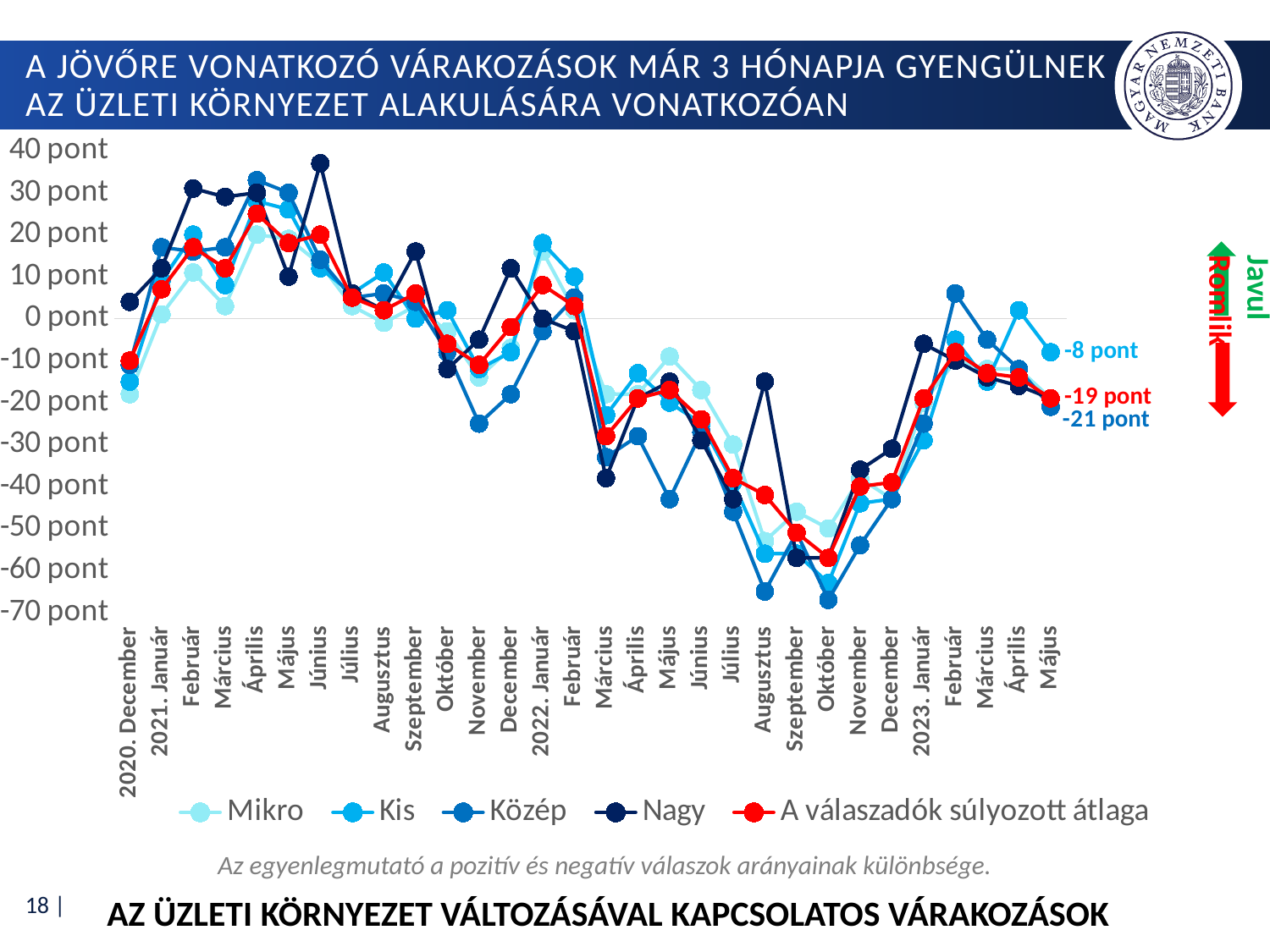
In which month does 'A válaszadók súlyozott átlaga' reach its lowest value? 2022. Október What is the value of the 'Közép' series in 2023. Május? -21 pont What is the value of the 'Kis' series in 2023. Május? -8 pont How many series does the legend list? 5 In 2023. Május, what is the difference between the 'Kis' value and the 'Közép' value? 13 pont Is the value for 'Nagy' in 2021. Június greater or less than 30 pont? greater Does 'A válaszadók súlyozott átlaga' rise or fall from 2022. Október to 2023. Február? rise What kind of chart is shown on the slide? line chart In 2023. Május, which is larger: the 'Kis' value or the 'Közép' value? Kis How many months (categories) are shown on the x axis? 30 What is the value of 'A válaszadók súlyozott átlaga' in 2023. Május? -19 pont Is the value for 'Közép' in 2022. Október greater or less than -60 pont? less